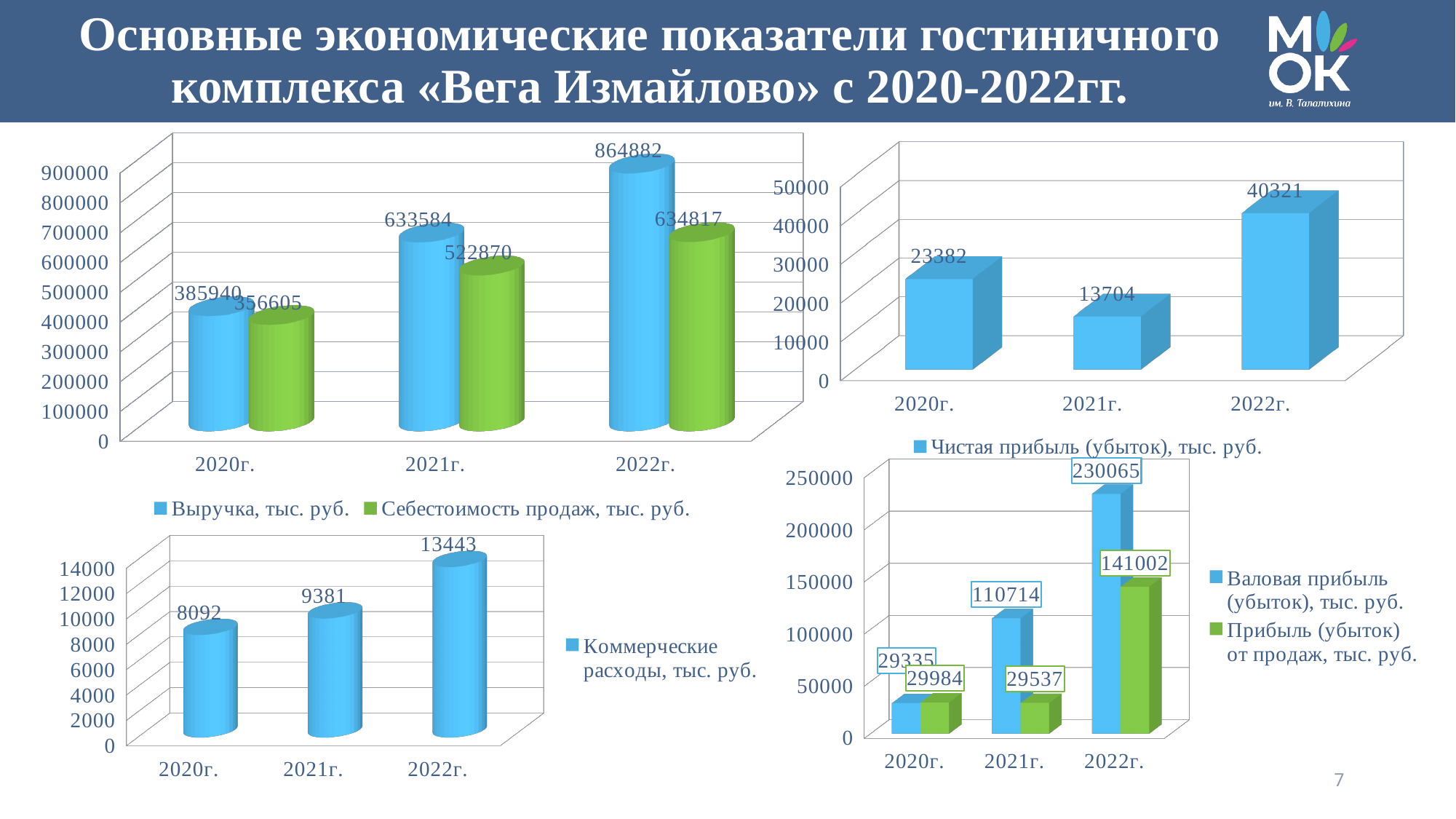
In the top-right chart (Чистая прибыль (убыток), тыс. руб.), what is the value for 2022г.? 40321 In the top-left chart, what is the value of Себестоимость продаж, тыс. руб. for 2020г.? 356605 What kind of chart is the bottom-left chart? bar chart In the top-right chart (Чистая прибыль (убыток), тыс. руб.), which year has the lowest value? 2021г. In the bottom-right chart, which is larger for 2020г.: Валовая прибыль (убыток) or Прибыль (убыток) от продаж? Прибыль (убыток) от продаж How many series does the legend of the top-left chart list? 2 In the bottom-left chart (Коммерческие расходы, тыс. руб.), what is the value for 2020г.? 8092 In the bottom-right chart, what is the value of Валовая прибыль (убыток), тыс. руб. for 2021г.? 110714 In the bottom-left chart (Коммерческие расходы, тыс. руб.), do the values rise or fall from 2020г. to 2022г.? rise In the top-left chart, what is the difference between Выручка and Себестоимость продаж for 2021г.? 110714 In the top-left chart, what is the value of Выручка, тыс. руб. for 2022г.? 864882 In the bottom-right chart, what is the difference between Валовая прибыль (убыток) and Прибыль (убыток) от продаж for 2022г.? 89063